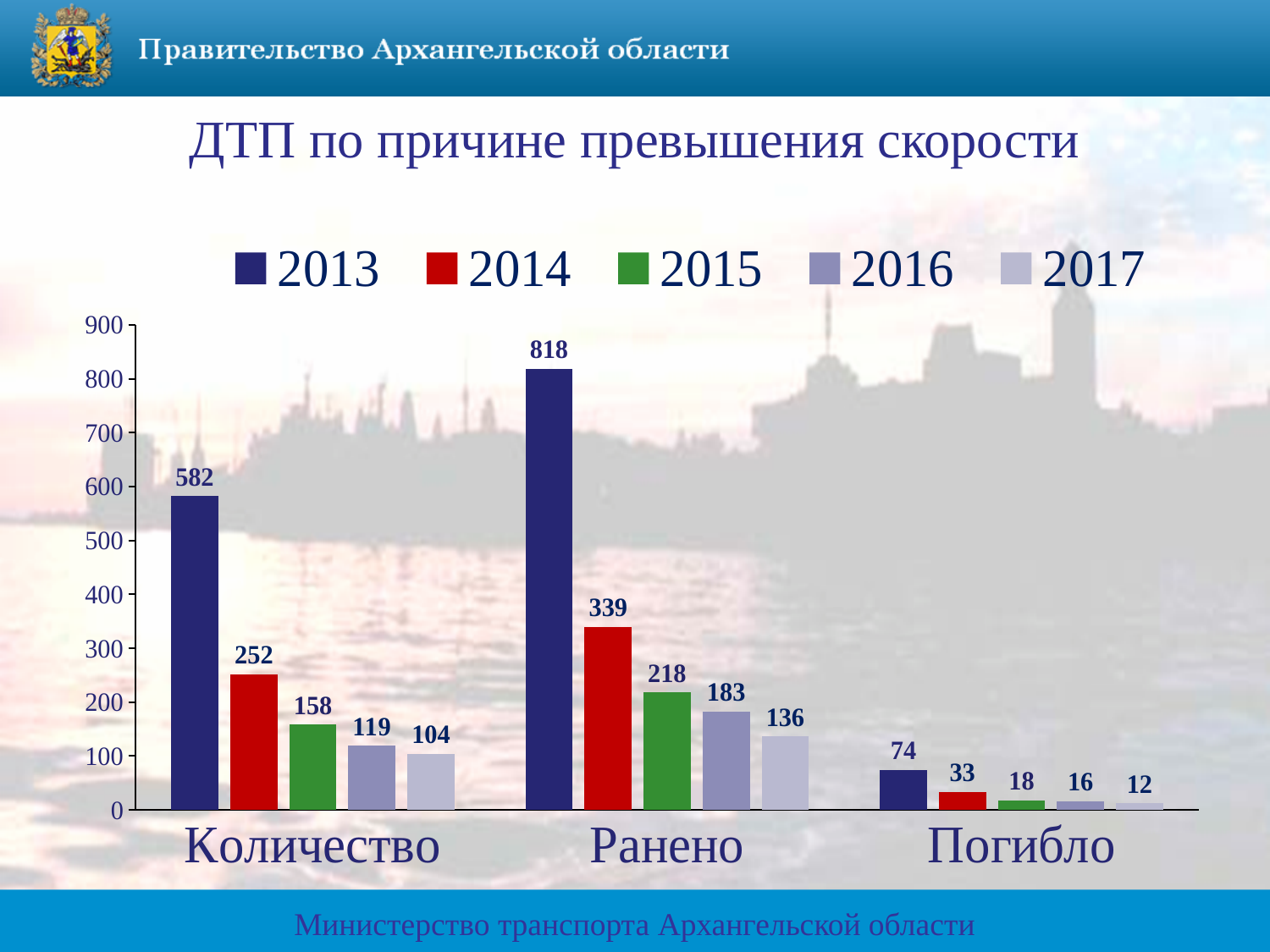
How many series does the legend list? 5 What is the difference between the 2016 and 2017 values in the Погибло category? 4 What kind of chart is shown on the slide? bar chart What is the value for 2013 in the Количество category? 582 How many categories are shown on the x axis? 3 Which year has the highest value in the Ранено category? 2013 What is the title of the chart? ДТП по причине превышения скорости What is the value for 2017 in the Погибло category? 12 Which is larger: the 2015 value for Количество or the 2016 value for Ранено? 2016 value for Ранено What is the value for 2015 in the Ранено category? 218 What is the difference between the 2013 and 2014 values in the Ранено category? 479 Which year has the lowest value in the Количество category? 2017